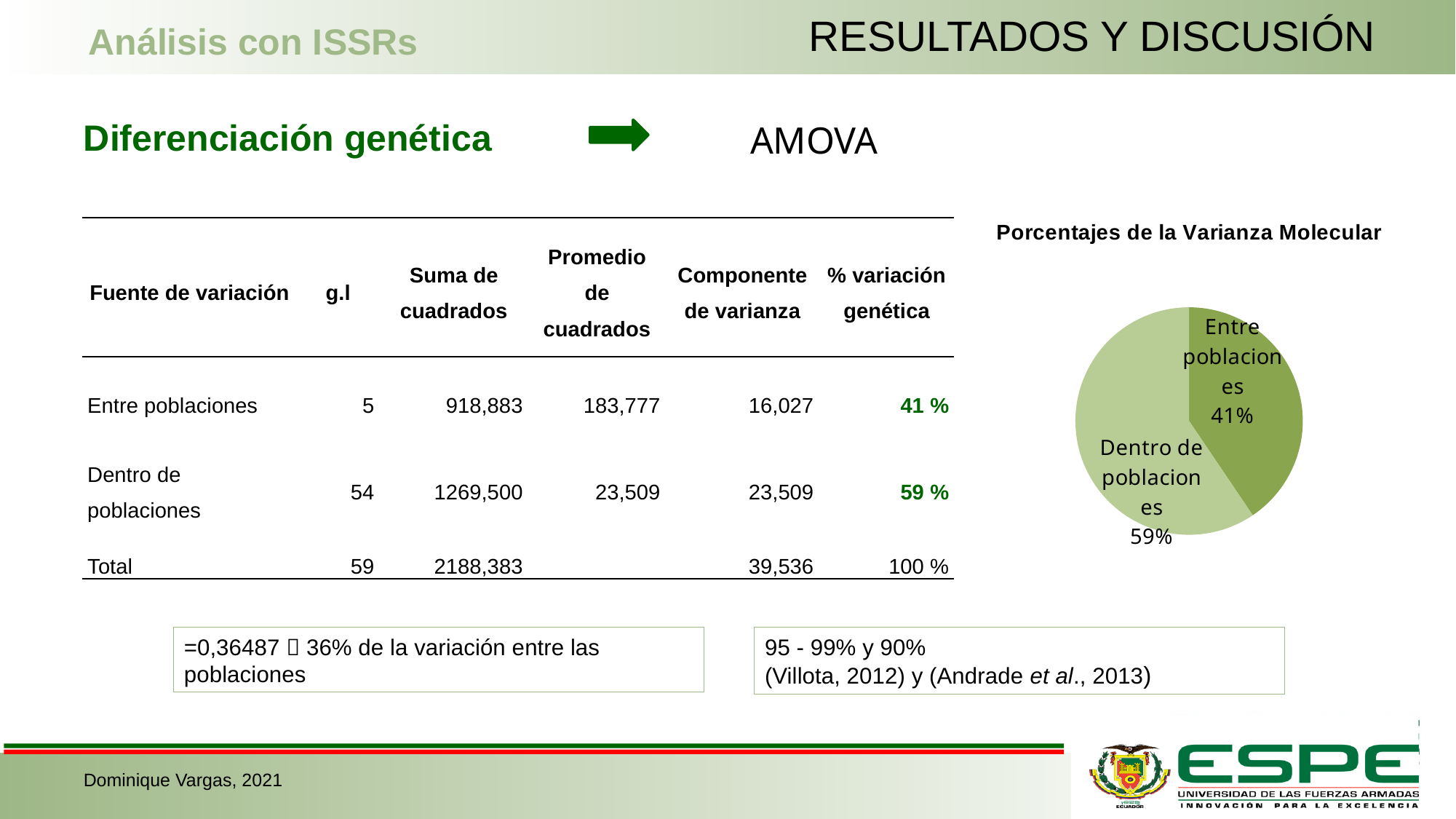
What is the difference in percentage points between the 'Dentro de poblaciones' and 'Entre poblaciones' slices? 18 How many slices does the pie chart have? 2 What share of the pie does 'Entre poblaciones' represent? 41% Which slice of the pie chart is the smallest? Entre poblaciones Which slice of the pie chart is the largest? Dentro de poblaciones What kind of chart is shown on the slide? pie chart Is the share for 'Entre poblaciones' greater or less than 50%? less Which is larger in the pie chart, 'Entre poblaciones' or 'Dentro de poblaciones'? Dentro de poblaciones What share of the pie does 'Dentro de poblaciones' represent? 59% What is the total of the two slices shown in the pie chart? 100% What is the title of the pie chart? Porcentajes de la Varianza Molecular